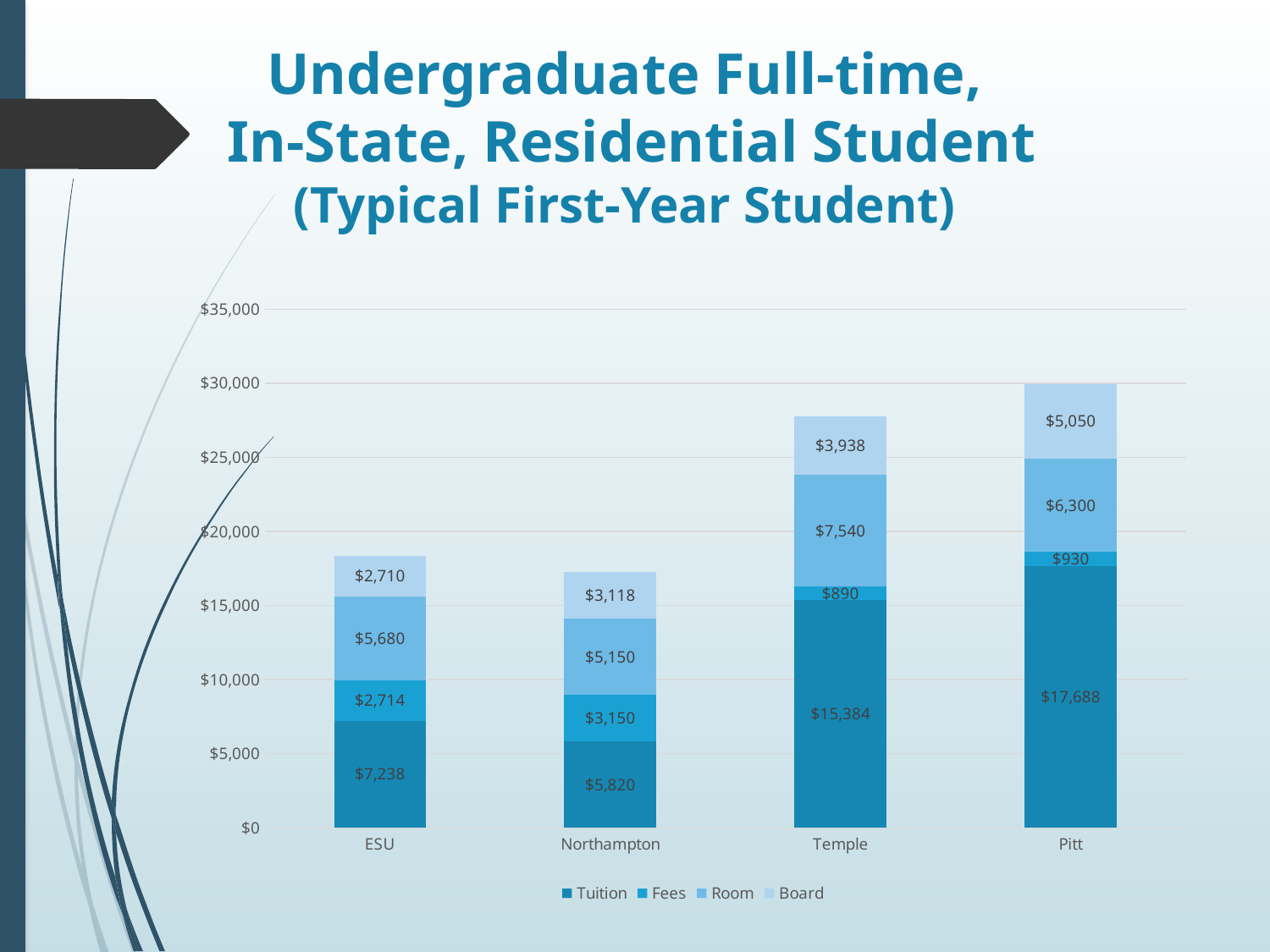
How many schools are shown on the x axis? 4 How many series does the legend list? 4 What is the Tuition value for Temple? $15,384 What is the Fees value for Northampton? $3,150 Which school has the highest Tuition? Pitt What is the Board value for Pitt? $5,050 What kind of chart is shown on the slide? Stacked bar chart What is the total of the stacked bar for ESU? $18,342 Which is larger, the Room value for ESU or the Room value for Northampton? ESU What is the difference between the Room value for Temple and the Room value for Pitt? $1,240 Is the total height of the Pitt bar greater or less than $25,000? greater Which school has the lowest Tuition? Northampton